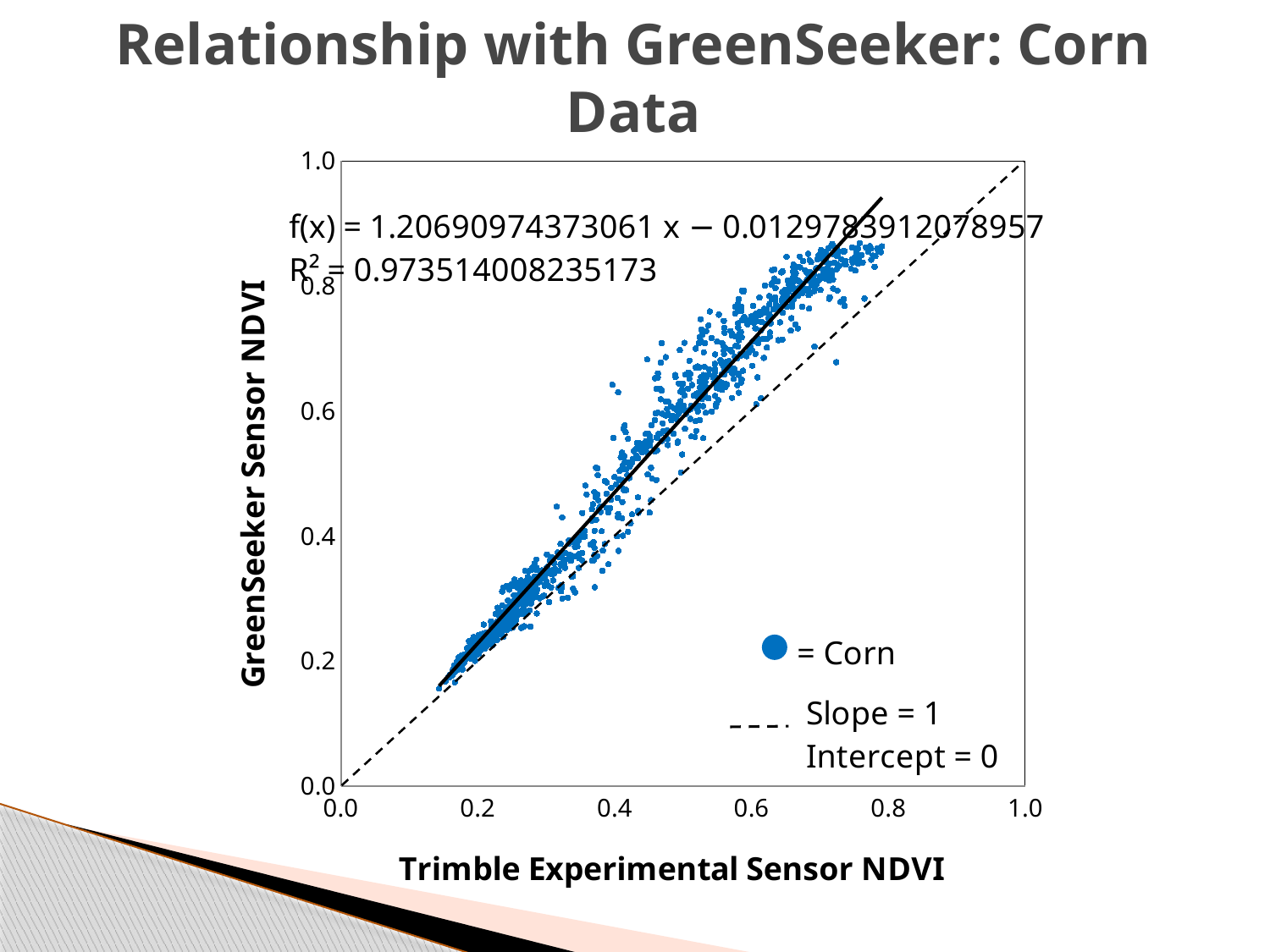
What is the slope of the fitted line f(x) shown on the chart? 1.20690974373061 How many data series of points are plotted on the chart? 1 What is the maximum value shown on the y axis? 1.0 What R² value is printed on the chart? 0.973514008235173 What intercept does the dashed reference line have according to the legend? 0 Is the slope of the fitted line greater or less than 1? greater What slope does the dashed reference line have according to the legend? 1 What is the intercept of the fitted line f(x) shown on the chart? −0.0129783912078957 What kind of chart is shown on the slide? scatter chart What is the label of the x axis? Trimble Experimental Sensor NDVI Do the GreenSeeker Sensor NDVI values rise or fall as Trimble Experimental Sensor NDVI increases? rise What is the title of the chart? Relationship with GreenSeeker: Corn Data